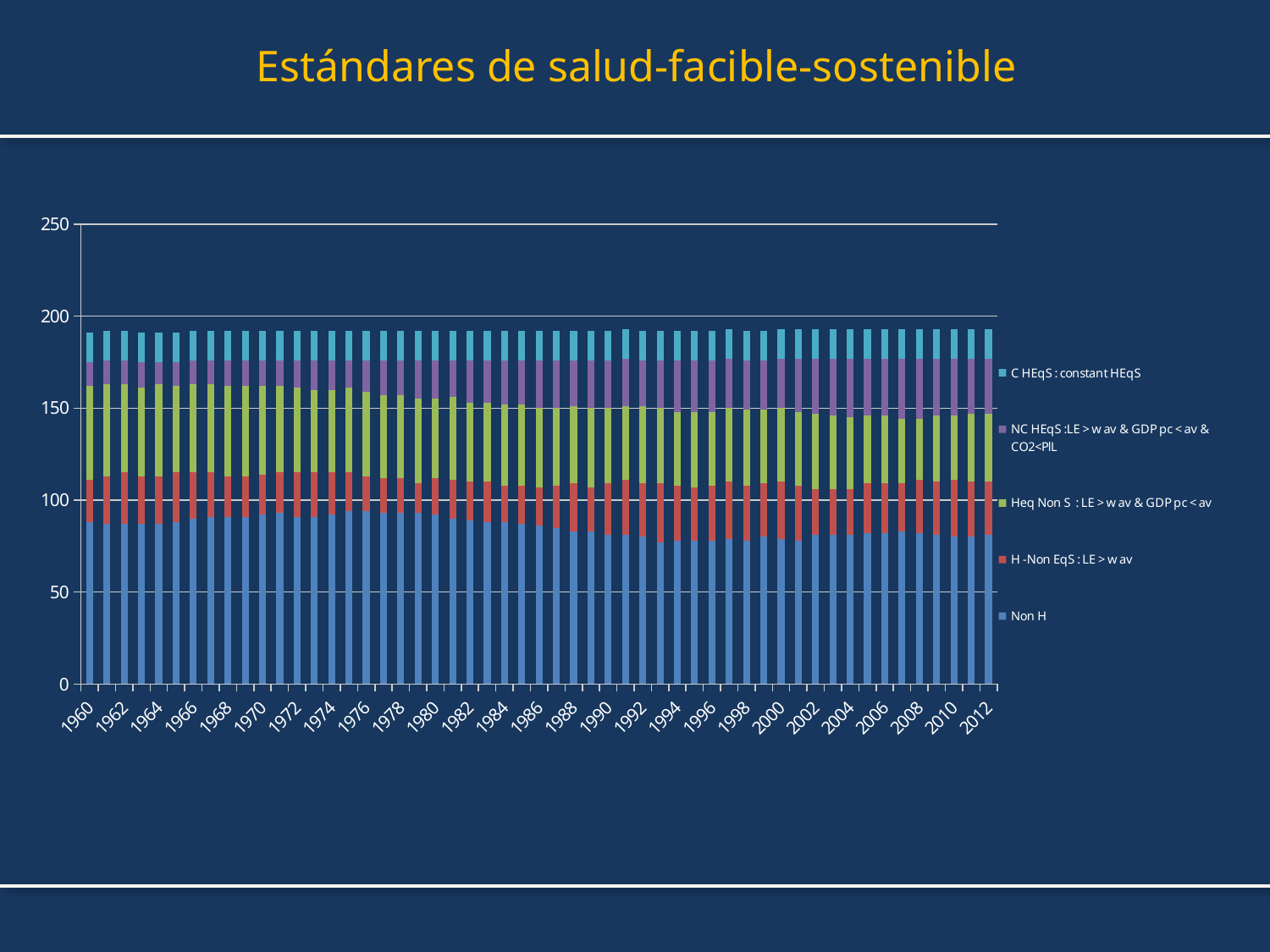
Is the total height of the stacked bar for 1960 greater or less than 200? less What is the first year shown on the x axis? 1960 What kind of chart is shown on the slide? stacked bar chart What is the title of the slide containing the chart? Estándares de salud-facible-sostenible Is the total height of the stacked bar for 2012 greater or less than 150? greater Is the value of the Non H series for 1960 greater or less than 50? greater What is the last year shown on the x axis? 2012 How many series does the legend list? 5 Which series is shown at the bottom of each stacked bar? Non H Which year has the larger Non H value, 1960 or 2012? 1960 Does the Non H series generally rise or fall from 1960 to 2012? fall